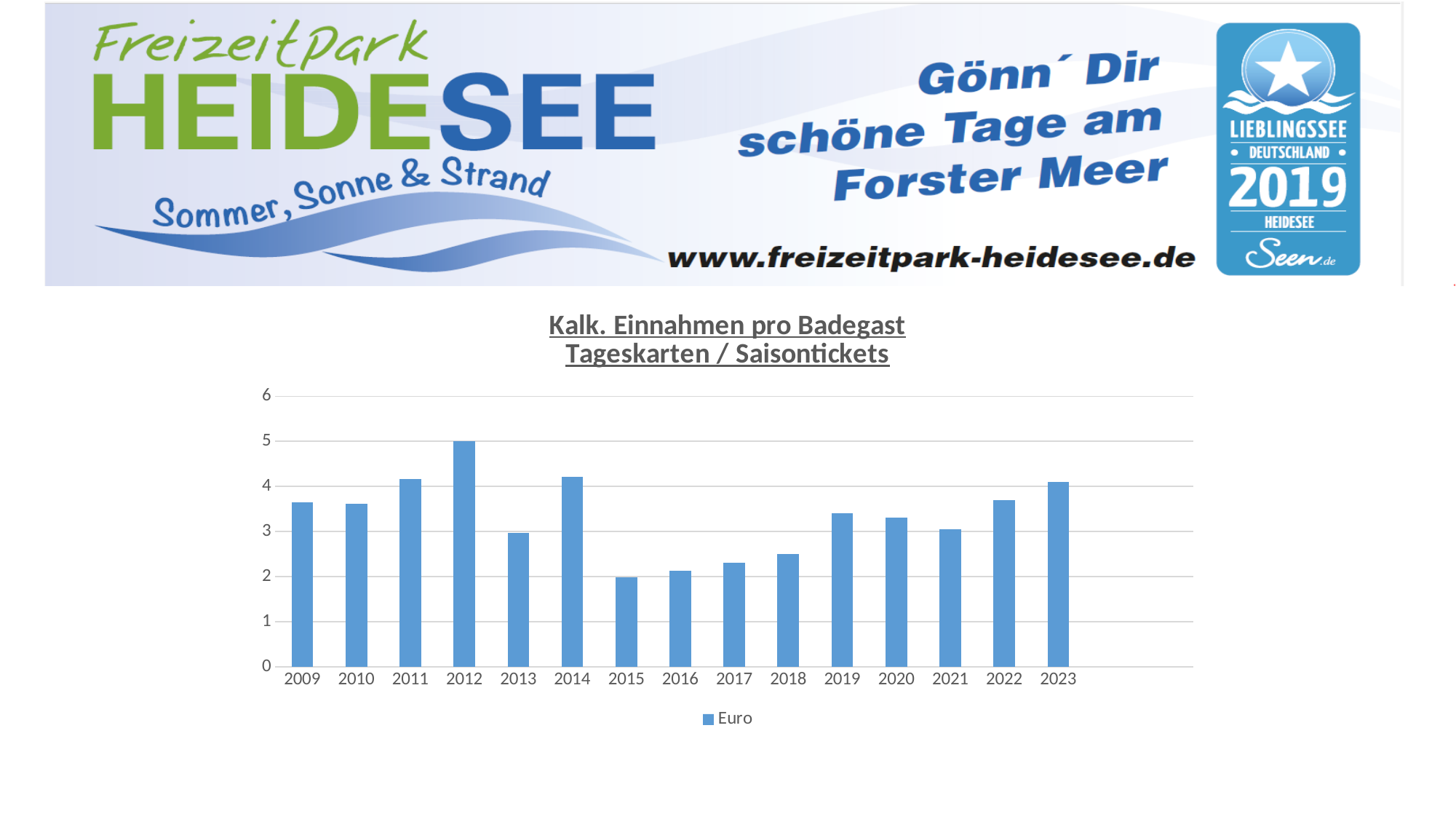
Which year has the lowest value in the chart? 2015 How many series does the legend list? 1 How many years are shown on the x axis of the chart? 15 Do the values rise or fall from 2015 to 2018? rise Which year has the larger value, 2014 or 2013? 2014 What kind of chart is shown on the slide? bar chart Is the value for 2017 greater or less than 3? less Which year has the highest value in the chart? 2012 What is the legend entry of the chart? Euro Is the value for 2012 greater or less than 4? greater Is the value for 2022 greater or less than 3? greater Which year has the larger value, 2023 or 2019? 2023